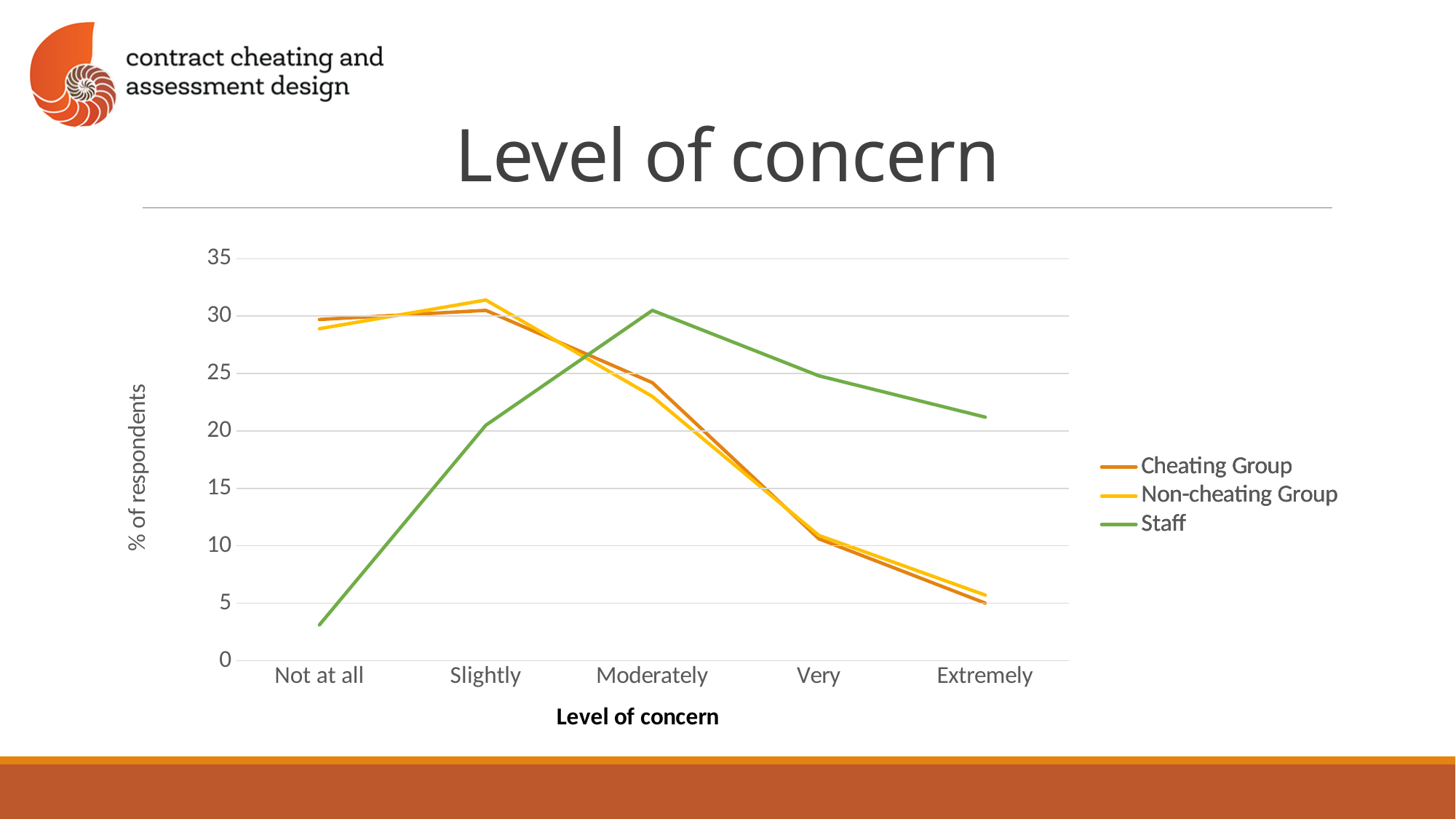
How many series does the legend list? 3 For the Cheating Group series, which level of concern has the lowest value? Extremely For the Staff series, which level of concern has the highest value? Moderately At the Very level of concern, which is larger: Staff or Cheating Group? Staff Is the Staff value for Moderately greater or less than 25? greater For the Staff series, which level of concern has the lowest value? Not at all Is the Non-cheating Group value for Extremely greater or less than 10? less Does the Staff series rise or fall from Moderately to Extremely? fall At the Not at all level of concern, which is larger: Cheating Group or Staff? Cheating Group How many levels of concern are shown on the x axis? 5 Is the Staff value for Not at all greater or less than 5? less What kind of chart is shown on the slide? line chart